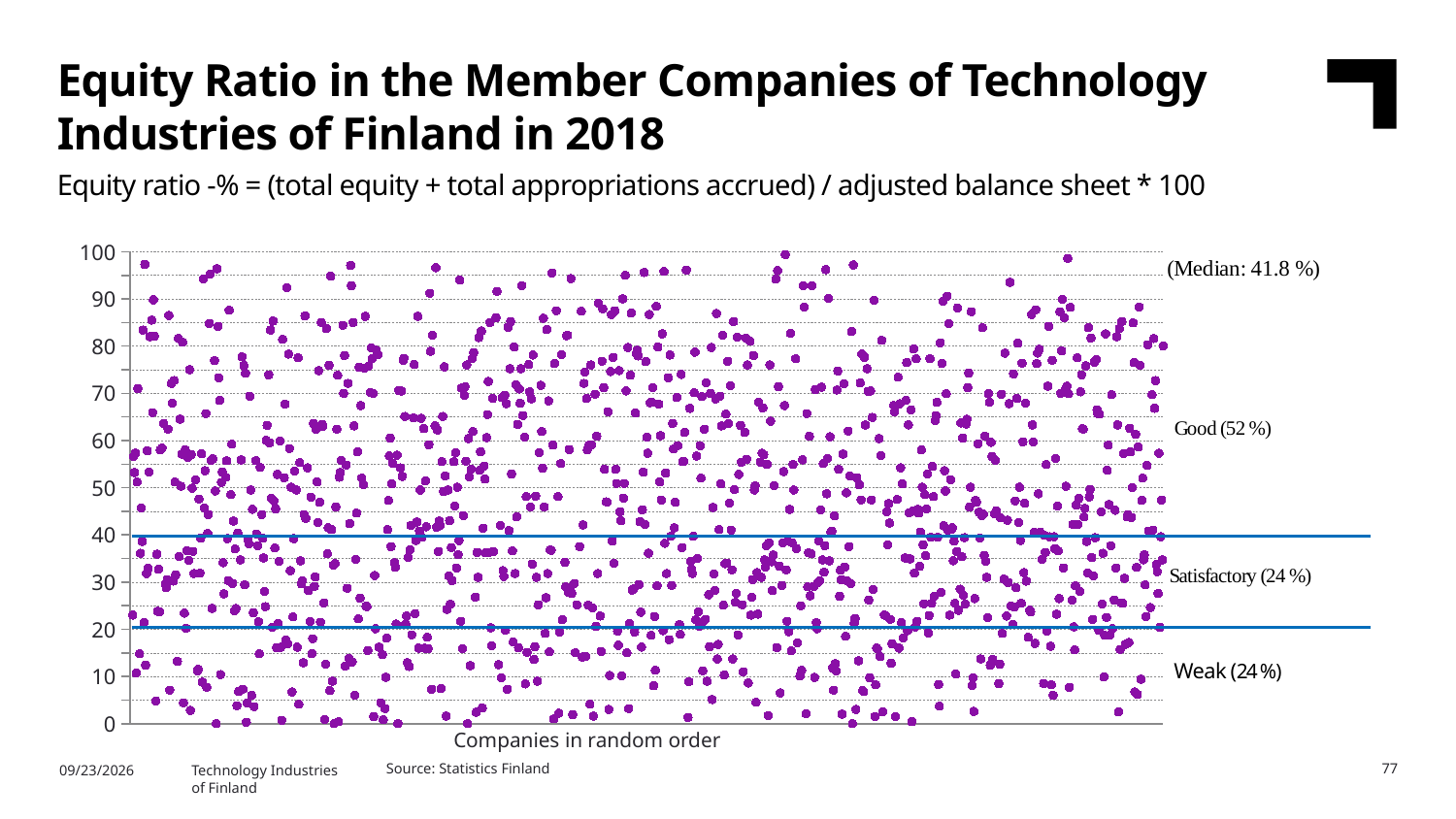
What is the difference in percentage points between the share of companies in the Good category and the share in the Satisfactory category? 28 What share of companies falls into the Satisfactory category? 24 % What is the median equity ratio shown on the chart? 41.8 % What is the label of the horizontal axis of the chart? Companies in random order Which category (Good, Satisfactory or Weak) contains the largest share of companies? Good What is the maximum value shown on the vertical axis of the chart? 100 How many equity ratio categories (Good, Satisfactory, Weak) are labelled on the chart? 3 What share of companies falls into the Weak category? 24 % What kind of chart is shown on the slide? Scatter chart Is the median equity ratio greater or less than 40? greater Is the share of companies in the Good category larger or smaller than the share in the Weak category? Larger What share of companies falls into the Good category? 52 %